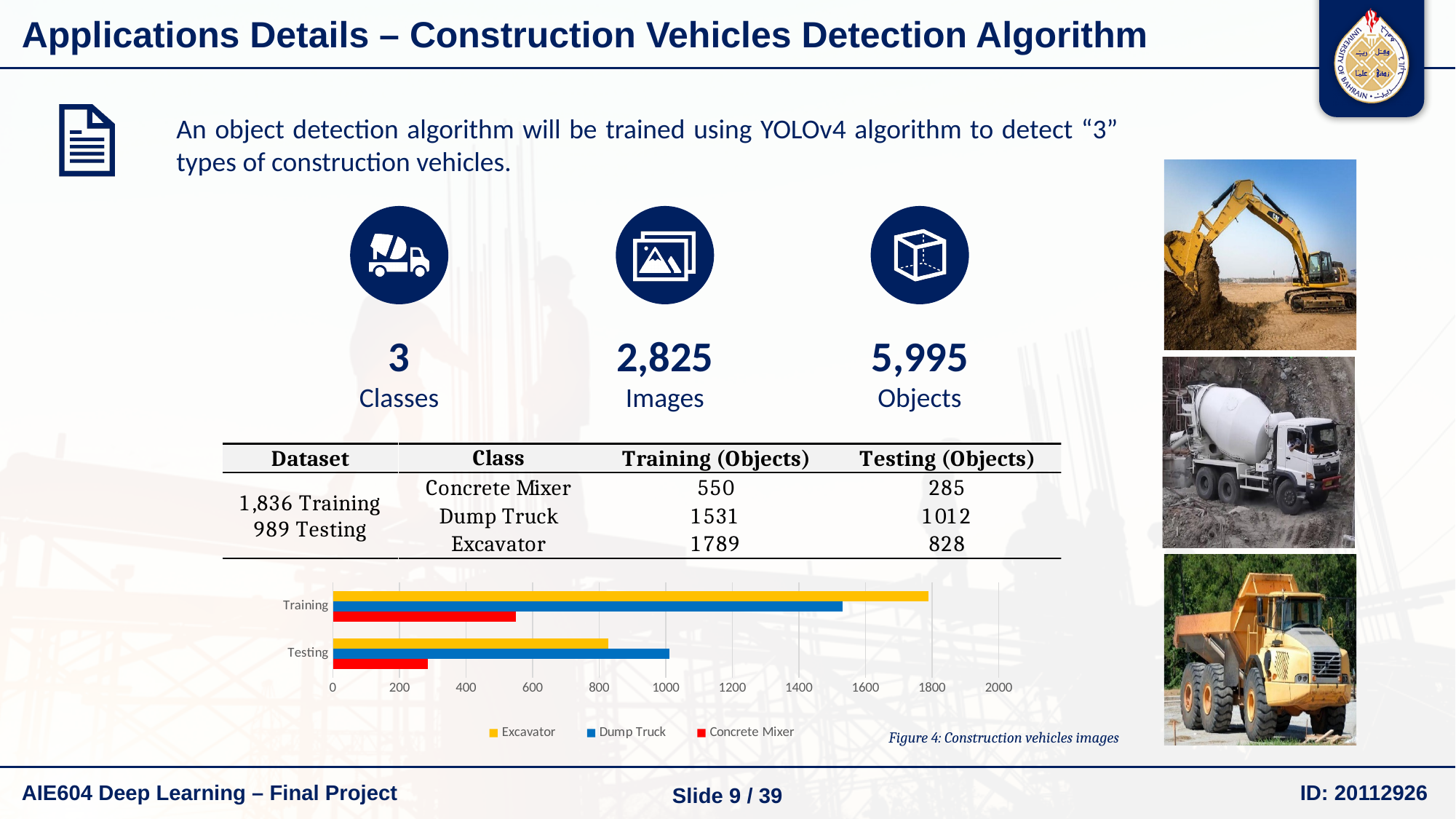
Is the Concrete Mixer value for Training greater or less than 600? less What colour represents Concrete Mixer in the chart? red What kind of chart is shown on the slide? bar chart In the Training category, which is larger: the Excavator bar or the Dump Truck bar? Excavator Which series has the longest bar in the Testing category? Dump Truck Which series has the longest bar in the Training category? Excavator How many categories are shown on the chart's vertical axis? 2 Is the Dump Truck value for Testing greater or less than 800? greater Is the Concrete Mixer value for Testing greater or less than 400? less Which series has the shortest bar in the Testing category? Concrete Mixer How many series does the chart legend list? 3